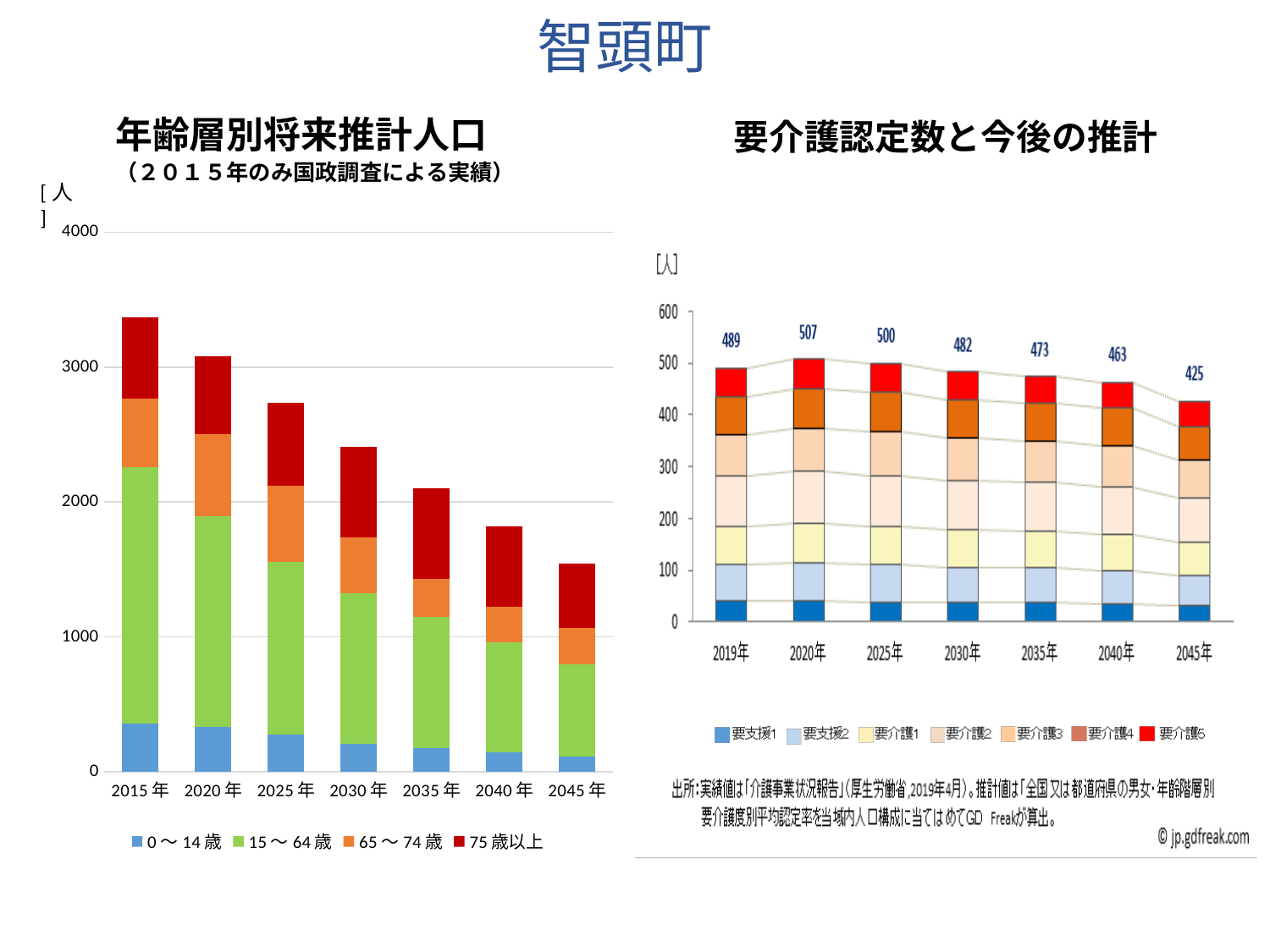
On the right chart (要介護認定数と今後の推計), what is the difference between the totals for 2020年 and 2045年? 82 On the left chart (年齢層別将来推計人口), is the total population for 2045年 greater or less than 2000? less On the left chart (年齢層別将来推計人口), how many series does the legend list? 4 On the left chart (年齢層別将来推計人口), does the total population rise or fall from 2015年 to 2045年? fall On the right chart (要介護認定数と今後の推計), how many series does the legend list? 7 On the left chart (年齢層別将来推計人口), is the total population for 2015年 greater or less than 3000? greater On the right chart (要介護認定数と今後の推計), what is the total value for 2020年? 507 On the right chart (要介護認定数と今後の推計), which year has the lowest total? 2045年 On the left chart (年齢層別将来推計人口), what kind of chart is it? Stacked bar chart On the right chart (要介護認定数と今後の推計), which year has the highest total? 2020年 On the left chart (年齢層別将来推計人口), how many years are shown on the x axis? 7 On the right chart (要介護認定数と今後の推計), what is the total value for 2045年? 425